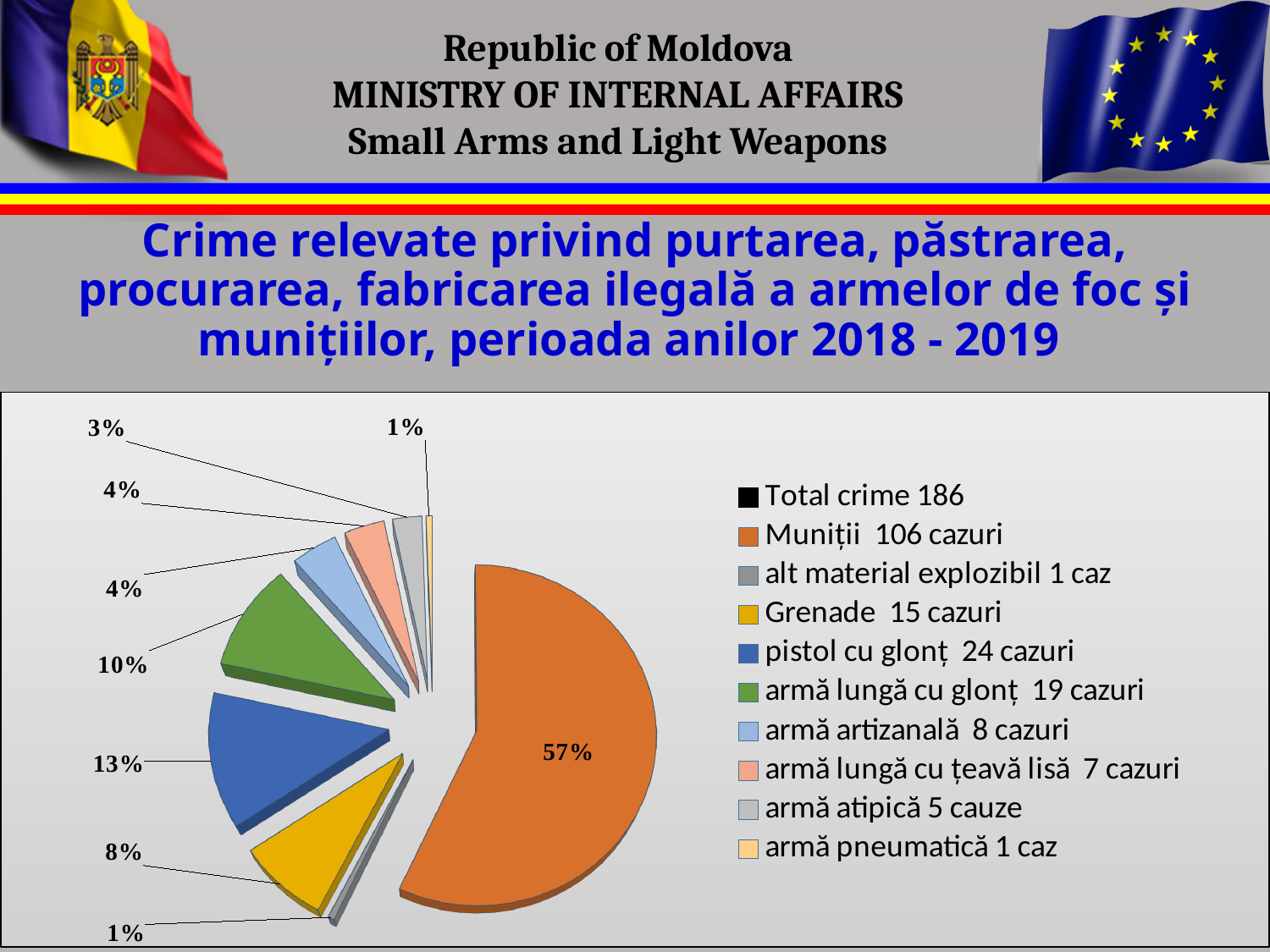
How many cases does the legend give for Grenade? 15 cazuri How many cases does the legend give for pistol cu glonț? 24 cazuri What share of the pie does the Muniții slice represent? 57% How many entries does the legend list? 10 What is the total number of crimes shown in the legend? 186 What share of the pie does the pistol cu glonț slice represent? 13% What share of the pie does the Grenade slice represent? 8% Which category has the largest slice of the pie? Muniții What is the difference in cases between pistol cu glonț (24) and armă lungă cu glonț (19)? 5 What kind of chart is shown on the slide? pie chart Which has more cases, pistol cu glonț or armă lungă cu glonț? pistol cu glonț